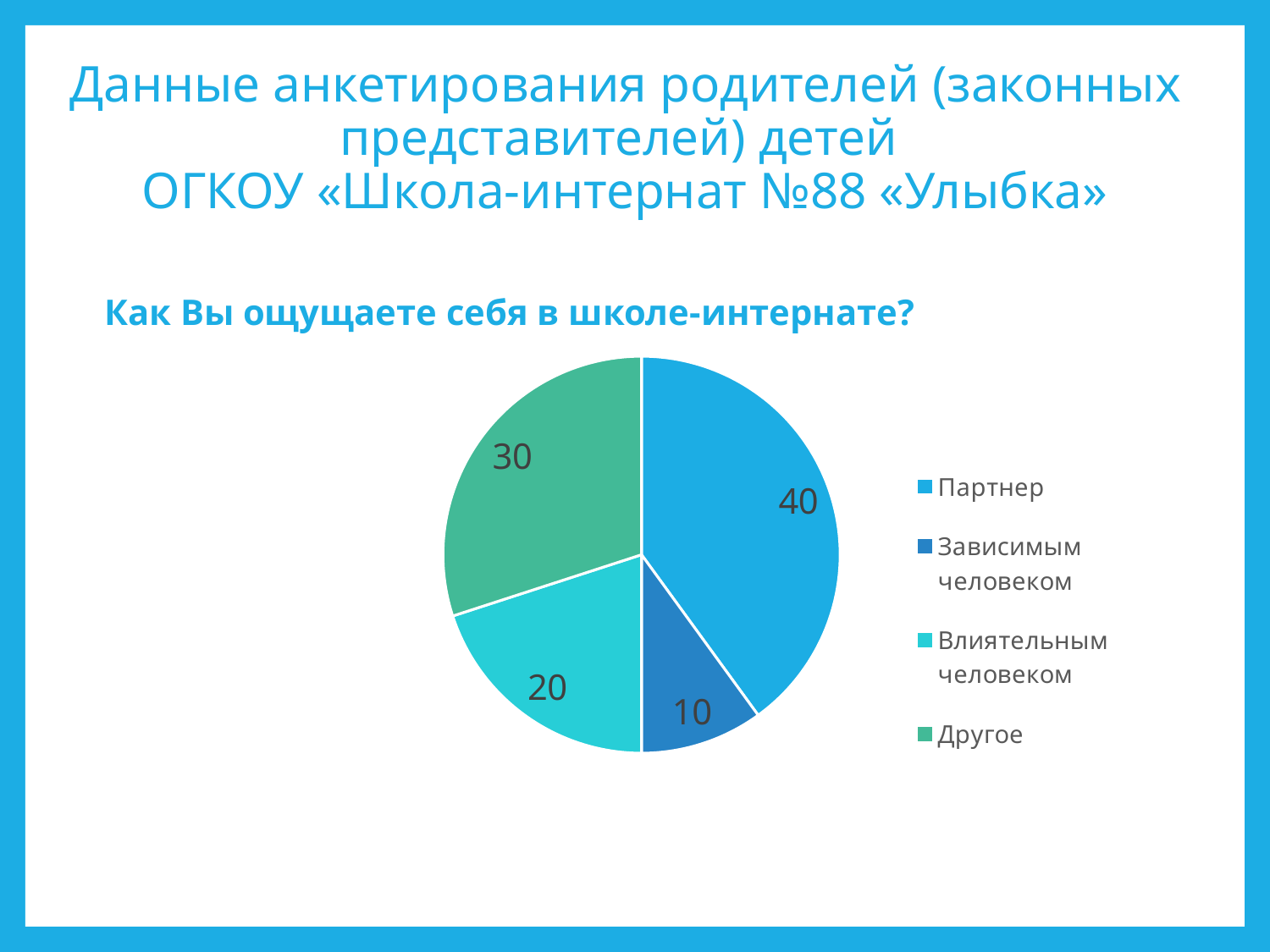
What is the value for Партнер? 40 What is the value for Зависимым человеком? 10 Which category has the largest slice? Партнер What is the value for Другое? 30 What kind of chart is shown on the slide? pie chart What is the difference between the values for Партнер and Другое? 10 How many slices does the pie chart have? 4 What is the value for Влиятельным человеком? 20 What question is the pie chart answering, according to the heading above it? Как Вы ощущаете себя в школе-интернате? What share of the pie does the Партнер slice represent? 40% Which category has the smallest slice? Зависимым человеком Which is larger, the value for Влиятельным человеком or the value for Другое? Другое